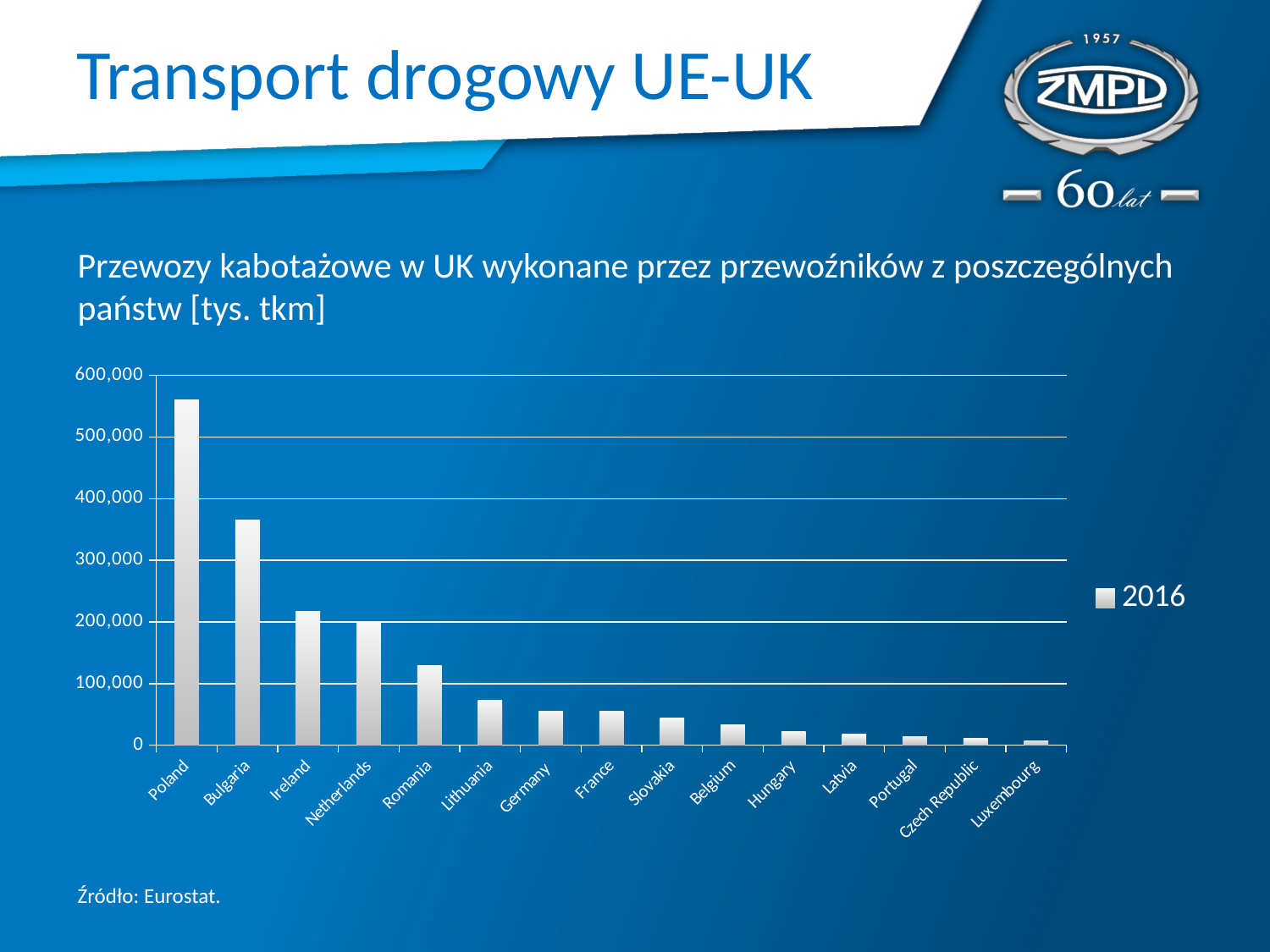
What kind of chart is shown on the slide? bar chart Which has a larger value, Poland or Bulgaria? Poland Which has a larger value, Ireland or Romania? Ireland How many countries are shown on the x axis of the chart? 15 Which country has the highest value in the chart? Poland Is the value for Bulgaria greater or less than 400,000? less Do the values rise or fall moving from left to right along the x axis? fall Is the value for Poland greater or less than 500,000? greater How many series does the chart legend list? 1 What year does the legend entry of the chart refer to? 2016 Which country has the lowest value in the chart? Luxembourg Is the value for Romania greater or less than 100,000? greater